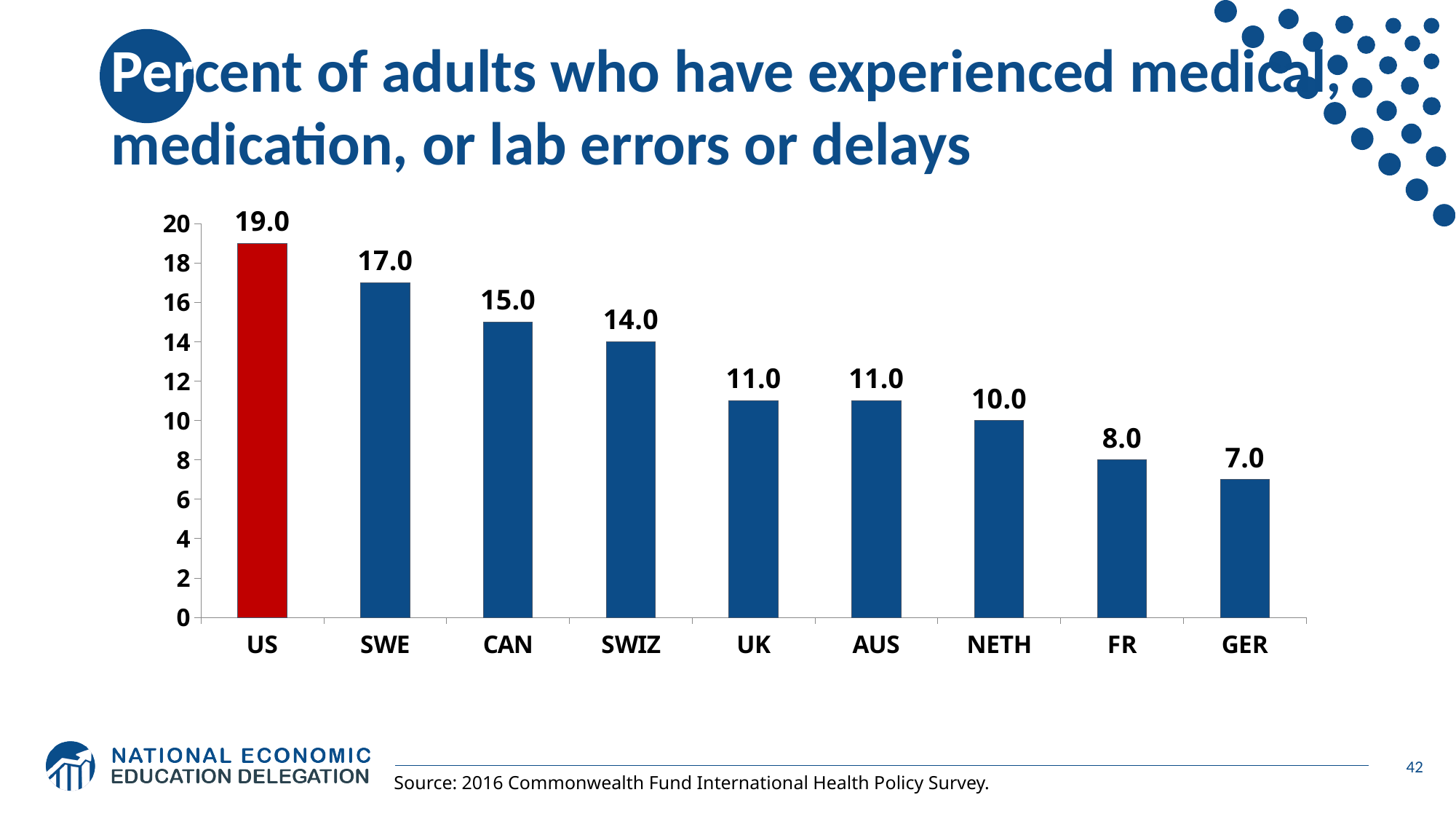
What kind of chart is shown on the slide? bar chart Which country has the lowest value? GER What is the difference between the values for the US and SWE? 2.0 What is the difference between the values for CAN and GER? 8.0 Which is larger, the value for FR or the value for NETH? NETH What is the value for NETH? 10.0 Which country has the highest value? US How many countries are shown on the chart? 9 What is the value for the US? 19.0 Which bar is coloured red rather than blue? US What is the value for SWIZ? 14.0 Do the values rise or fall from left to right across the chart? fall